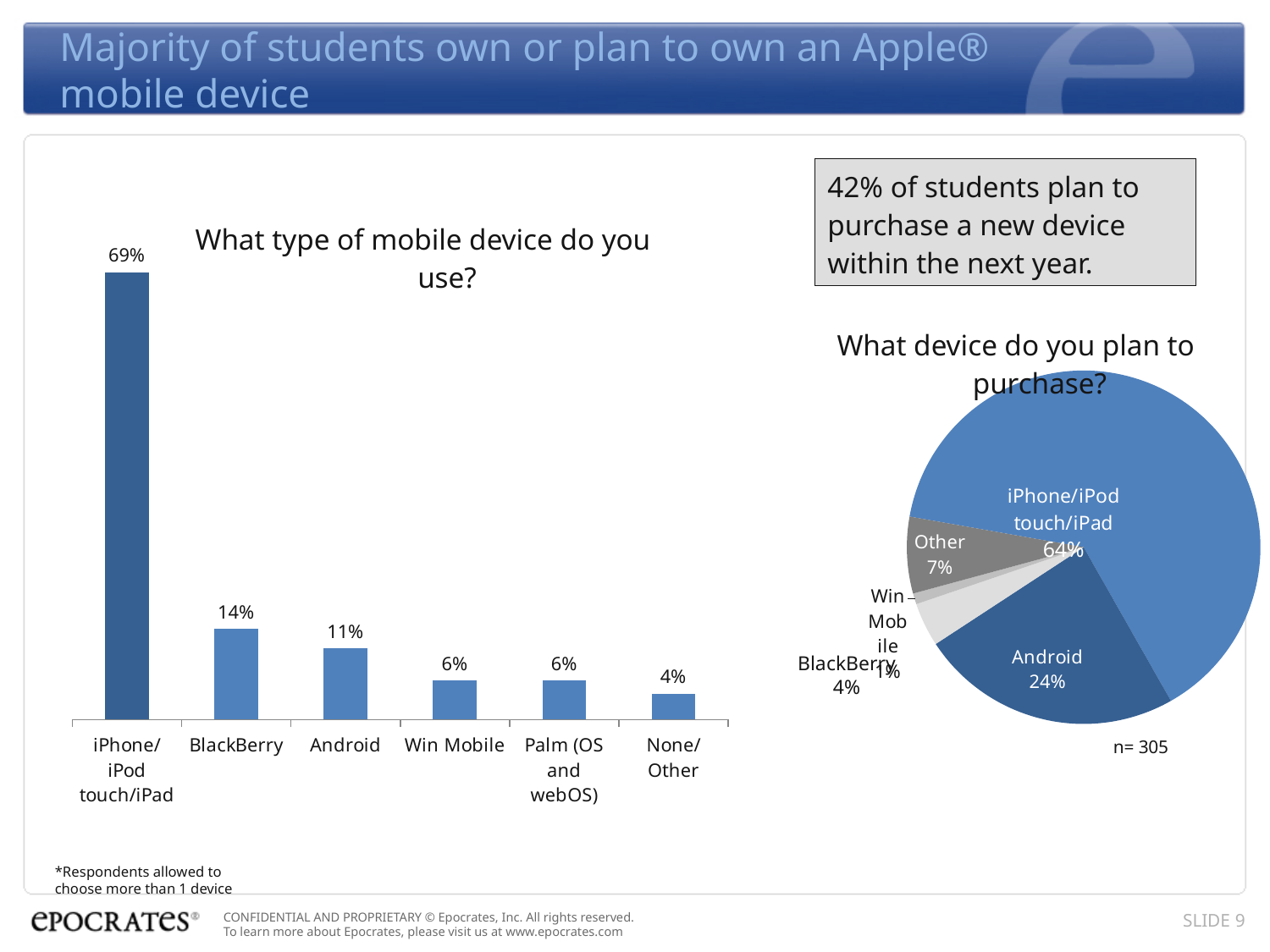
In the chart 'What type of mobile device do you use?', what is the value for Android? 11% In the chart 'What device do you plan to purchase?', what share does Other have? 7% In the chart 'What type of mobile device do you use?', what is the difference between the iPhone/iPod touch/iPad value and the BlackBerry value? 55% What kind of chart is 'What type of mobile device do you use?'? Bar chart What kind of chart is 'What device do you plan to purchase?'? Pie chart In the chart 'What type of mobile device do you use?', what is the value for BlackBerry? 14% In the chart 'What device do you plan to purchase?', which slice is the largest? iPhone/iPod touch/iPad In the chart 'What type of mobile device do you use?', which category has the highest value? iPhone/iPod touch/iPad In the chart 'What type of mobile device do you use?', how many categories are shown? 6 In the chart 'What device do you plan to purchase?', what share does Android have? 24% In the chart 'What device do you plan to purchase?', which is larger, BlackBerry or Other? Other In the chart 'What type of mobile device do you use?', which category has the lowest value? None/Other